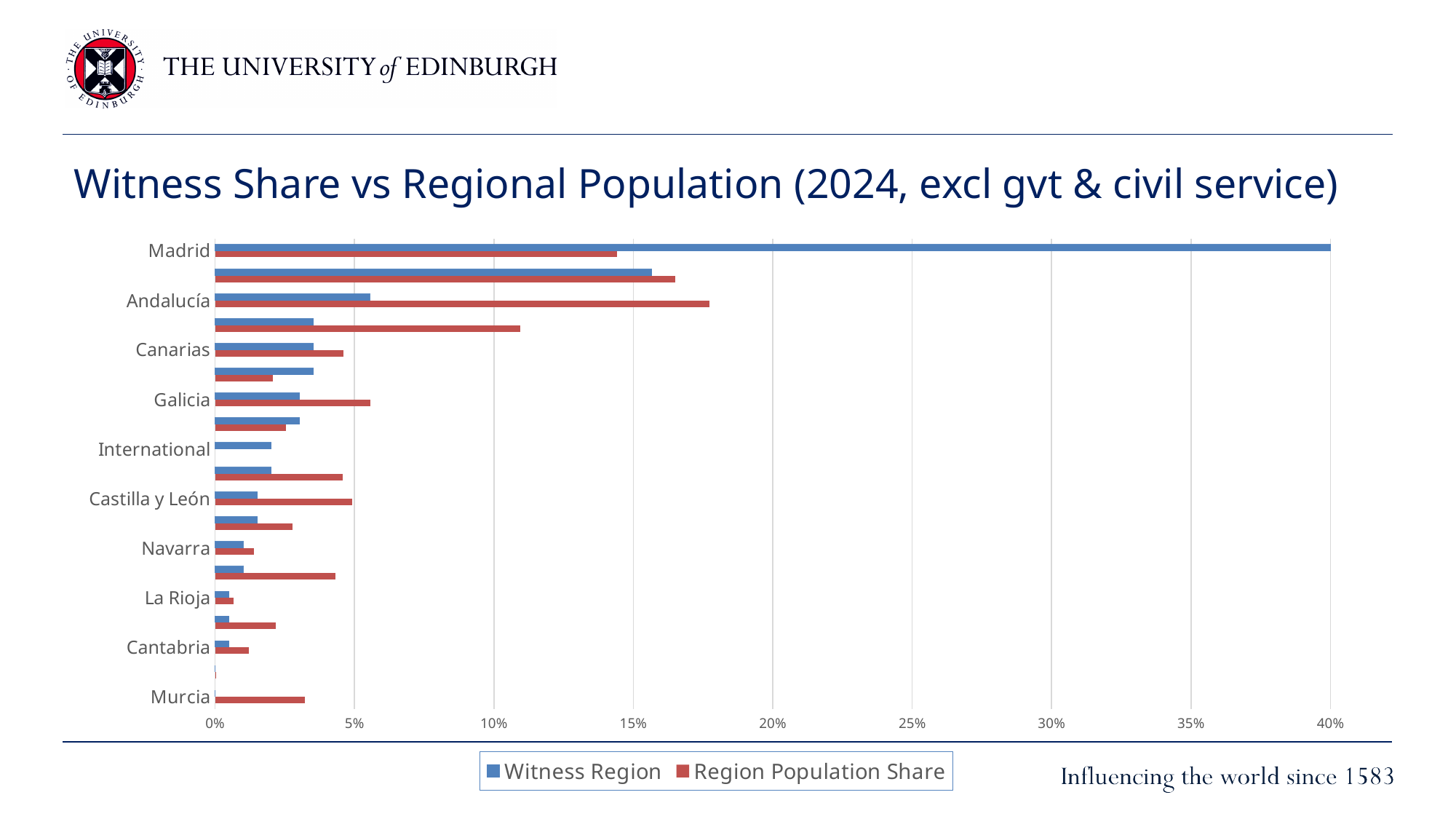
Is the Witness Region value for Madrid greater or less than 35%? greater What kind of chart is shown on the slide? Bar chart For Madrid, which is larger: Witness Region or Region Population Share? Witness Region For Andalucía, which is larger: Witness Region or Region Population Share? Region Population Share Is the Region Population Share value for Madrid greater or less than 10%? greater Which labelled region has the highest Region Population Share value? Andalucía Which region has the highest Witness Region value? Madrid What colour are the Witness Region bars? Blue Is the Region Population Share value for Andalucía greater or less than 15%? greater How many series does the legend list? 2